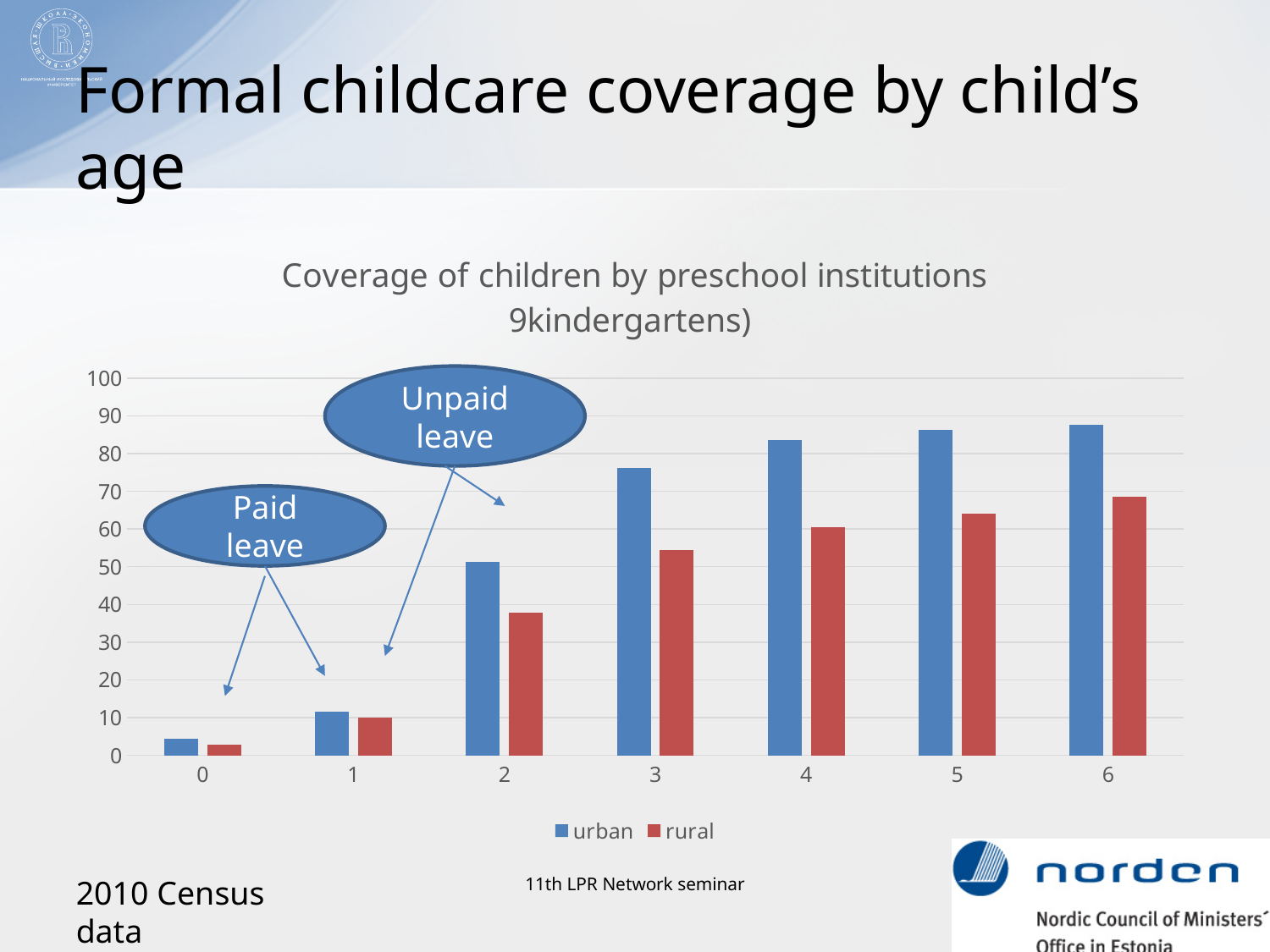
Is the urban value for age 1 greater or less than 20? less Which age has the highest rural coverage? 6 At age 3, which is larger, the urban or the rural value? urban Which age has the lowest urban coverage? 0 How many series does the legend list? 2 How many age categories are shown on the x axis? 7 Is the rural value for age 2 greater or less than 50? less Is the rural value for age 6 greater or less than 60? greater What kind of chart is shown on the slide? bar chart Do the urban values rise or fall as the child's age increases from 0 to 6? rise What are the two series named in the legend? urban and rural